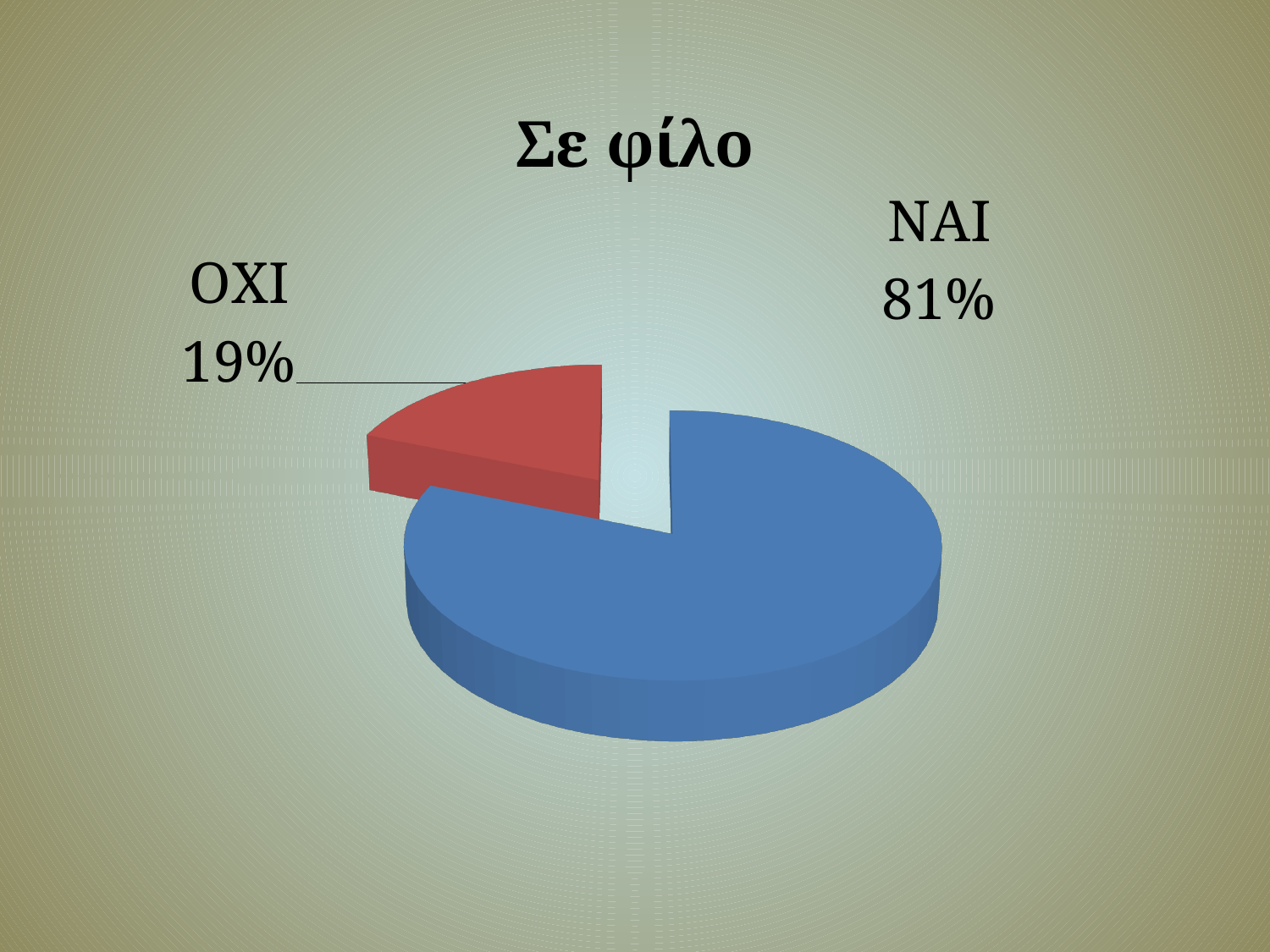
What share of the pie does ΝΑΙ represent? 81% Which category has the largest share of the pie? ΝΑΙ What colour is the ΟΧΙ slice? red What percentage is shown for ΝΑΙ? 81% How many slices does the pie chart have? 2 What percentage is shown for ΟΧΙ? 19% What kind of chart is shown on the slide? pie chart Which category has the smallest share of the pie? ΟΧΙ Which is larger, the share for ΝΑΙ or the share for ΟΧΙ? ΝΑΙ What is the title of the chart? Σε φίλο What is the difference in percentage points between ΝΑΙ and ΟΧΙ? 62